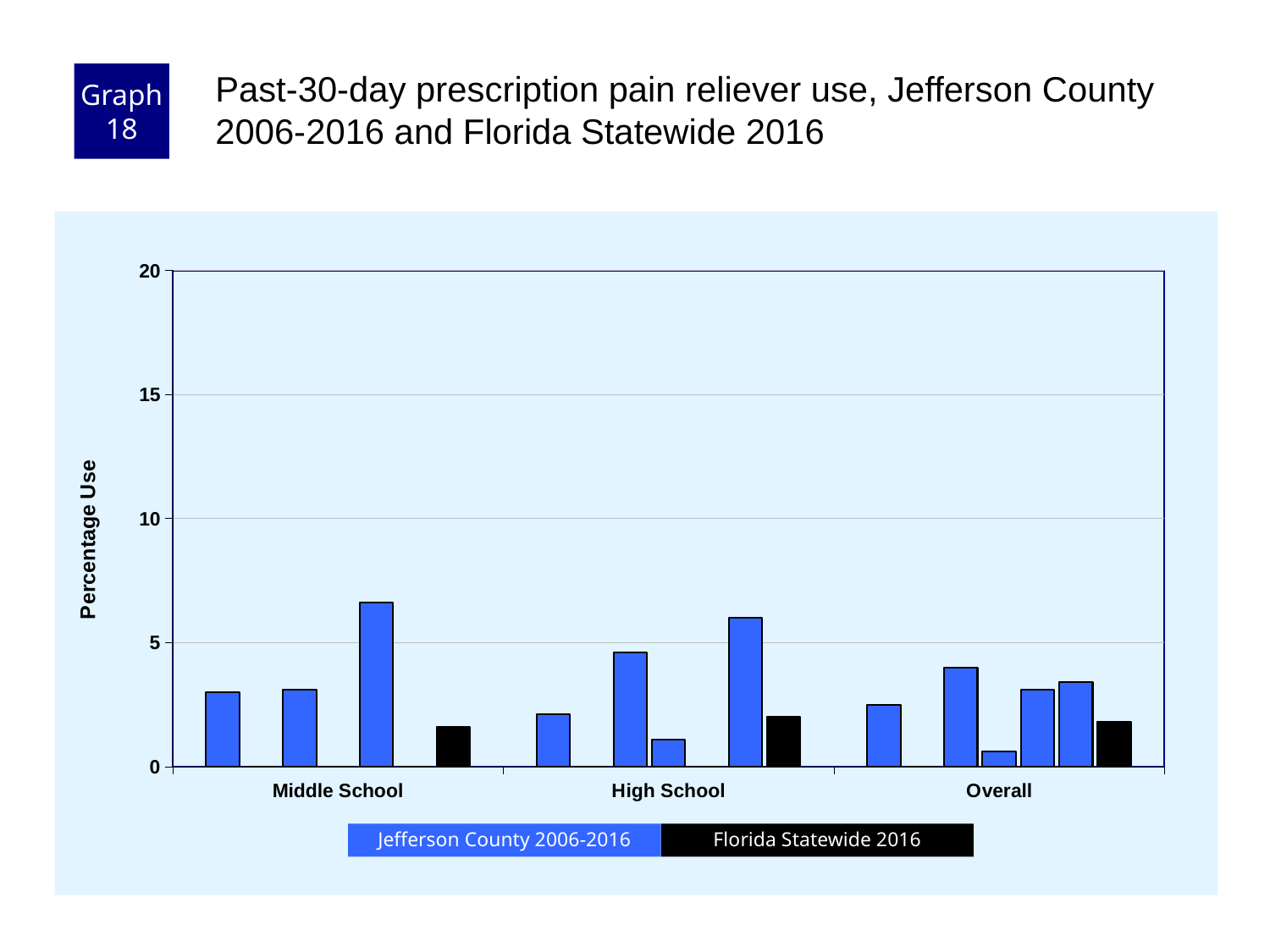
Is the highest value on the chart greater or less than 10? less What kind of chart is shown on the slide? Bar chart How many series does the legend list? 2 Is the tallest Jefferson County 2006-2016 bar in the Overall group greater or less than 5? less In the Overall group, is the Florida Statewide 2016 bar taller or shorter than the tallest Jefferson County 2006-2016 bar? shorter Is the Florida Statewide 2016 bar for High School taller or shorter than the Florida Statewide 2016 bar for Middle School? taller How many categories are shown on the x axis? 3 Which category group contains the tallest bar on the chart? Middle School Is the Florida Statewide 2016 value for Middle School greater or less than 5? less What is the title of the y axis? Percentage Use